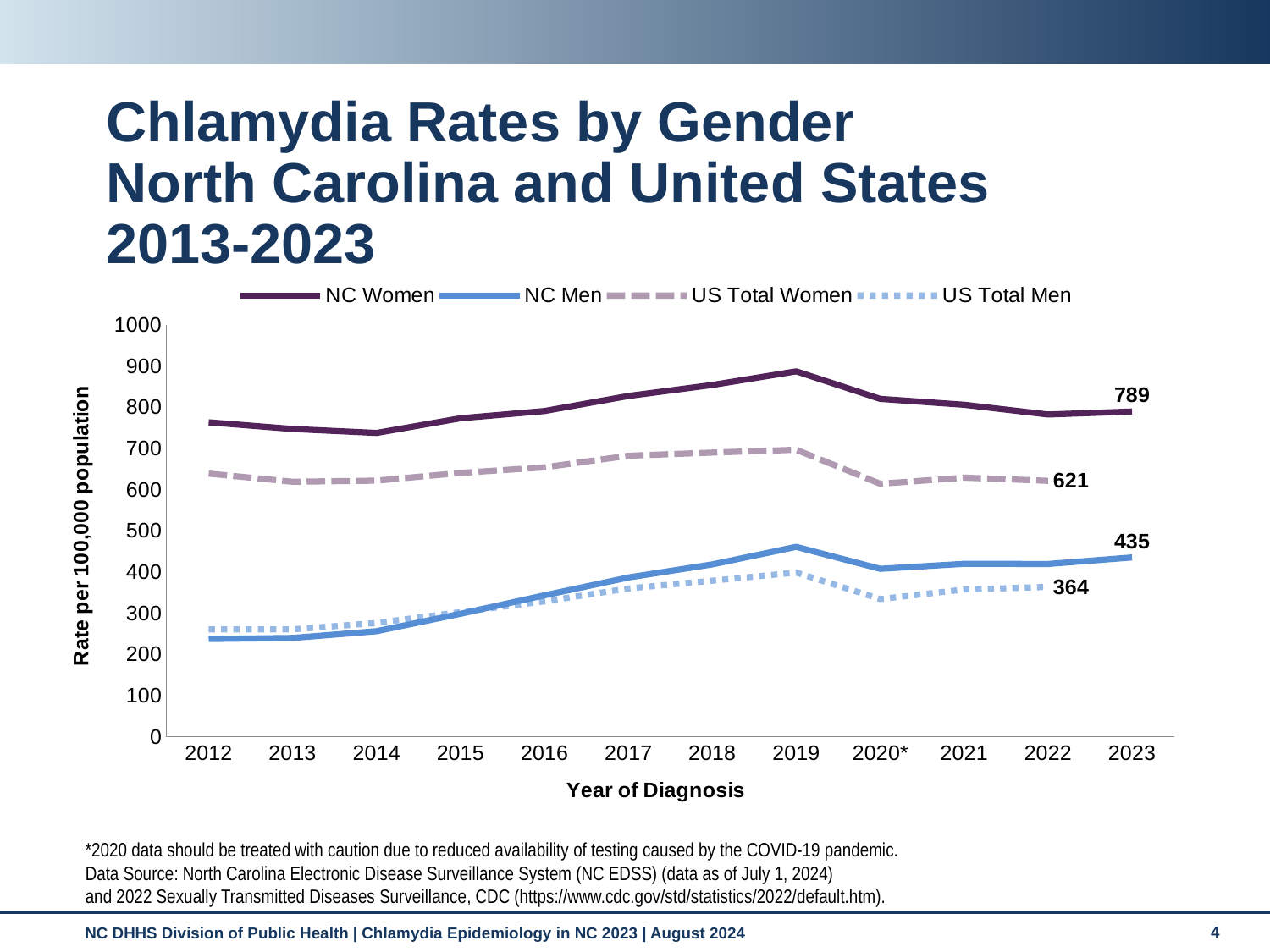
Which series has the highest rate in 2019? NC Women What is the chlamydia rate for NC Men in 2023? 435 What is the chlamydia rate for NC Women in 2023? 789 What is the chlamydia rate for US Total Men in 2022? 364 What kind of chart is shown on the slide? Line chart What is the difference between the NC Women rate and the NC Men rate in 2023? 354 How many years are shown on the x axis? 12 How many series does the legend list? 4 Is the value for NC Women in 2019 greater or less than 800? greater What is the difference between the US Total Women rate and the US Total Men rate in 2022? 257 What is the chlamydia rate for US Total Women in 2022? 621 Does the NC Men rate rise or fall from 2012 to 2019? Rise